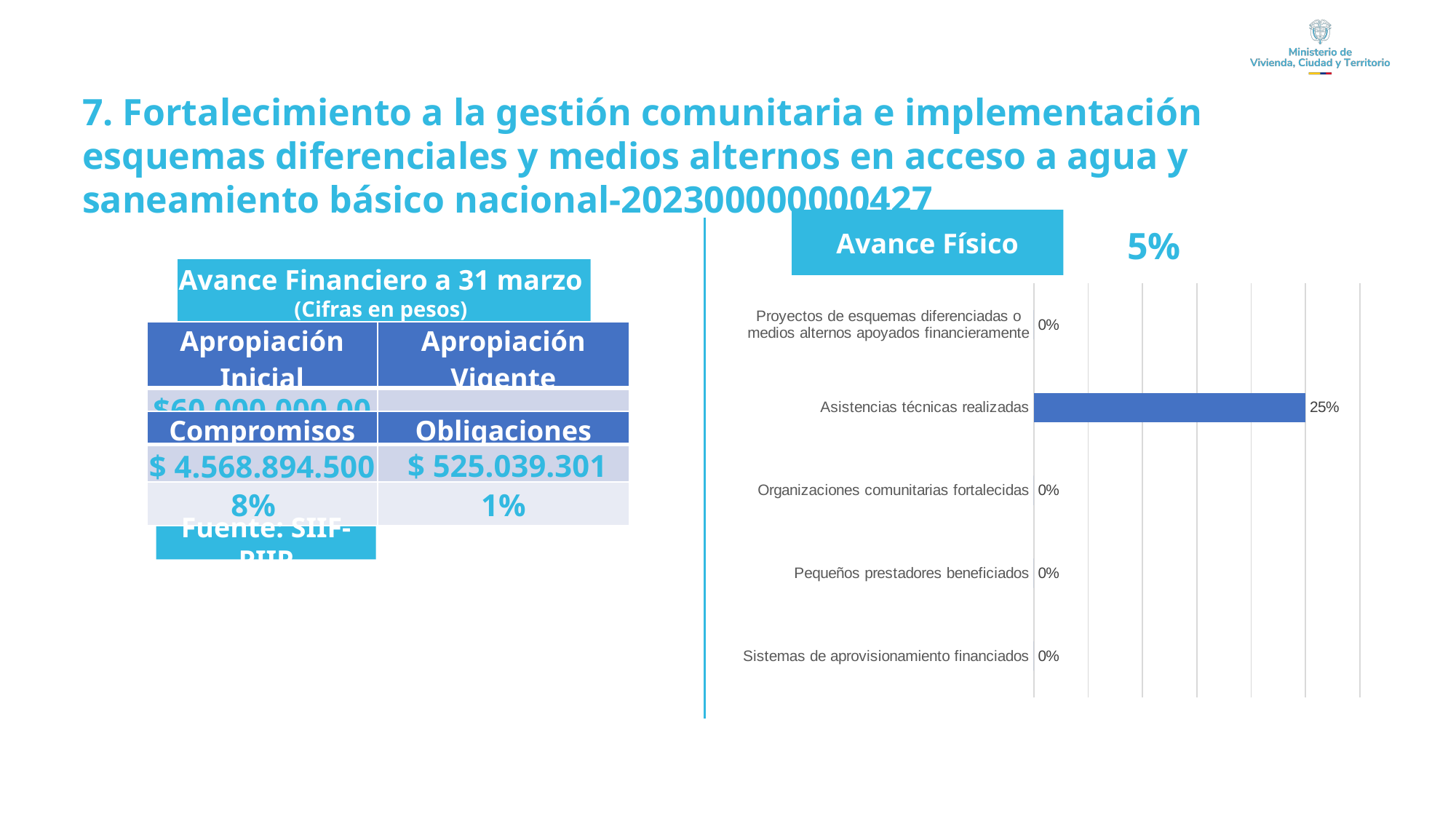
What is the difference between Asistencias técnicas realizadas and Pequeños prestadores beneficiados? 25% What is the value for Organizaciones comunitarias fortalecidas? 0% Which category has the highest value? Asistencias técnicas realizadas What is the value for Pequeños prestadores beneficiados? 0% What kind of chart is shown? Bar chart Which is larger, Asistencias técnicas realizadas or Organizaciones comunitarias fortalecidas? Asistencias técnicas realizadas How many categories does the chart show? 5 What is the value for Sistemas de aprovisionamiento financiados? 0% What is the value for Proyectos de esquemas diferenciadas o medios alternos apoyados financieramente? 0% How many categories have a value of 0%? 4 What is the title of the chart? Avance Físico What is the value for Asistencias técnicas realizadas? 25%